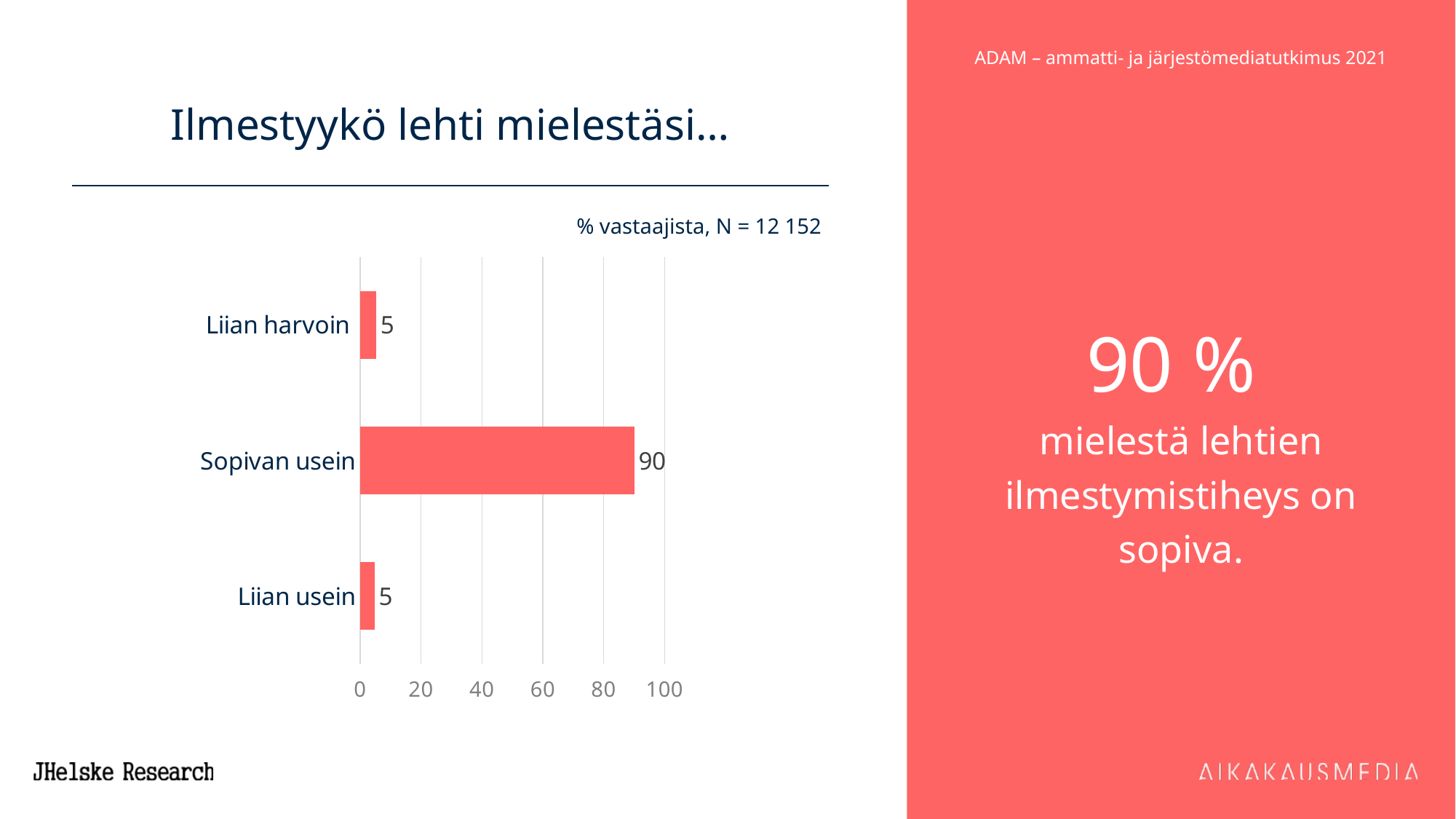
What kind of chart is shown on the slide? Bar chart What is the difference between the values for "Sopivan usein" and "Liian harvoin"? 85 Which is larger, the value for "Sopivan usein" or the value for "Liian usein"? Sopivan usein Is the value for "Sopivan usein" greater or less than 80? greater What is the value for "Liian usein"? 5 Is the value for "Liian harvoin" greater or less than 20? less Which category has the highest value? Sopivan usein What is the sample size (N) stated above the chart? 12 152 What is the value for "Sopivan usein"? 90 What is the value for "Liian harvoin"? 5 What is the title of the chart? Ilmestyykö lehti mielestäsi… How many categories are shown in the chart? 3